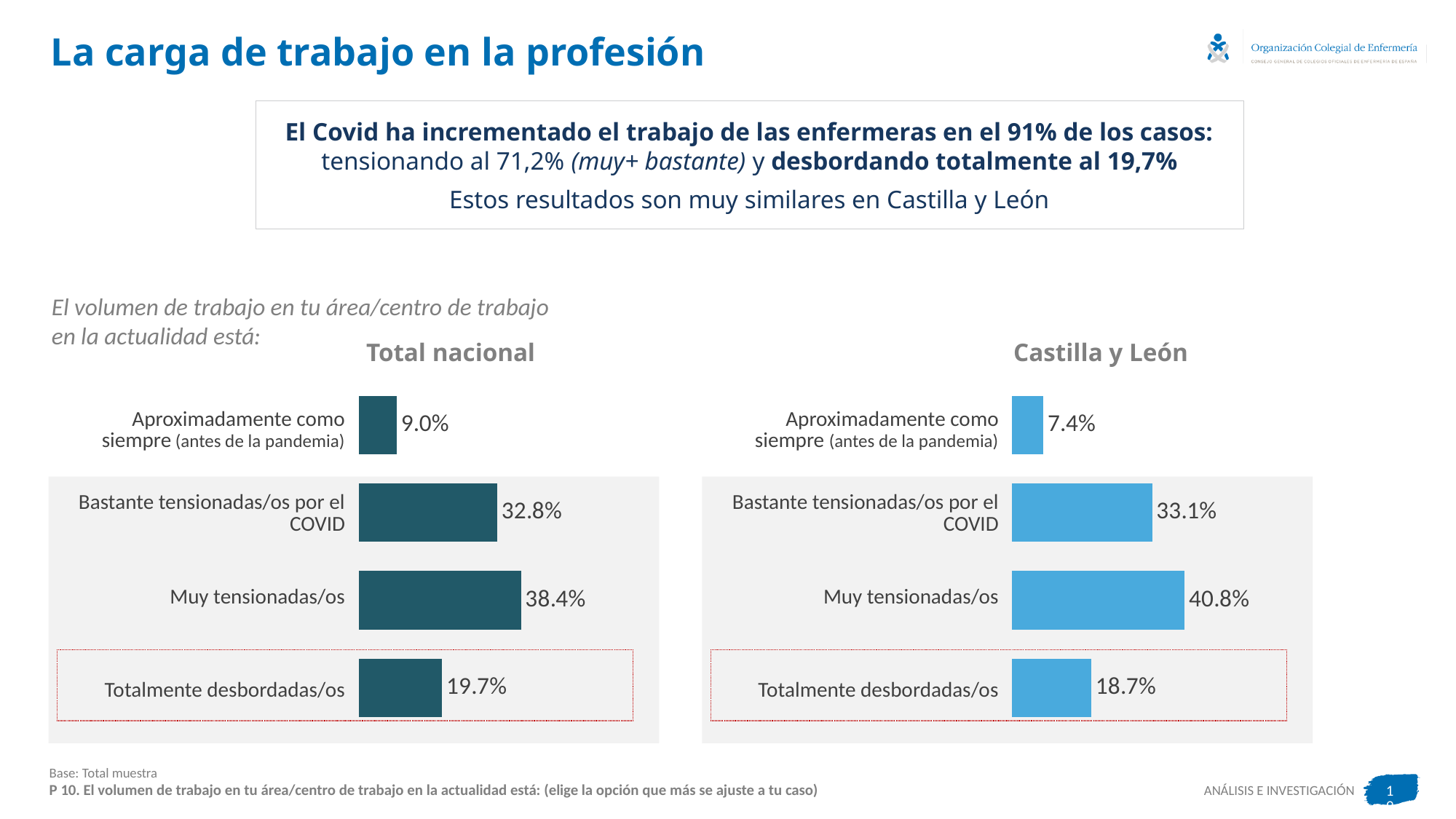
In the 'Total nacional' chart, what is the value for 'Muy tensionadas/os'? 38.4% How many charts are on the slide? 2 In the 'Total nacional' chart, what is the value for 'Aproximadamente como siempre (antes de la pandemia)'? 9.0% Which is larger: 'Totalmente desbordadas/os' in the 'Total nacional' chart or in the 'Castilla y León' chart? Total nacional In the 'Castilla y León' chart, which category has the lowest value? Aproximadamente como siempre (antes de la pandemia) In the 'Castilla y León' chart, what is the value for 'Bastante tensionadas/os por el COVID'? 33.1% How many categories does the 'Total nacional' chart show? 4 In the 'Castilla y León' chart, what is the value for 'Totalmente desbordadas/os'? 18.7% In the 'Total nacional' chart, which category has the highest value? Muy tensionadas/os In the 'Castilla y León' chart, what is the difference between 'Muy tensionadas/os' and 'Totalmente desbordadas/os'? 22.1% In the 'Total nacional' chart, what is the difference between 'Muy tensionadas/os' and 'Bastante tensionadas/os por el COVID'? 5.6% What kind of chart is the 'Castilla y León' chart? Bar chart